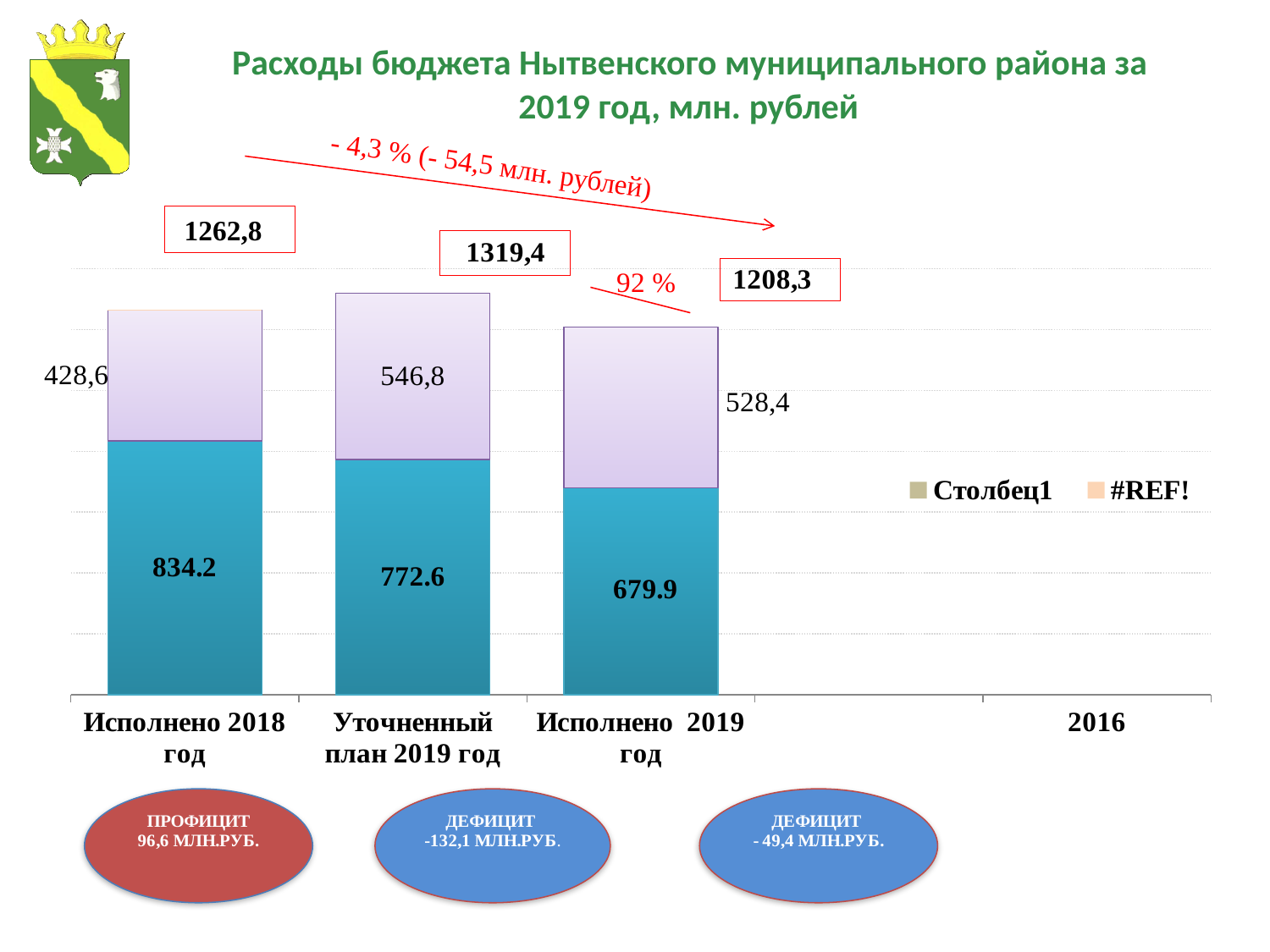
What is the value of the top (lilac) segment for Уточненный план 2019 год? 546,8 Do the bottom (teal) segment values rise or fall from left to right across the three bars? fall What is the total shown above the bar for Исполнено 2019 год? 1208,3 What kind of chart is shown on the slide? stacked bar chart Which is larger: the bottom (teal) segment for Исполнено 2018 год or for Исполнено 2019 год? Исполнено 2018 год Which bar has the lowest total value? Исполнено 2019 год What is the difference between the bottom (teal) segment values for Исполнено 2018 год and Уточненный план 2019 год? 61.6 What is the value of the bottom (teal) segment for Исполнено 2019 год? 679.9 Which bar has the highest total value? Уточненный план 2019 год How many entries does the legend list? 2 What is the value of the bottom (teal) segment for Исполнено 2018 год? 834.2 What is the total shown above the bar for Уточненный план 2019 год? 1319,4